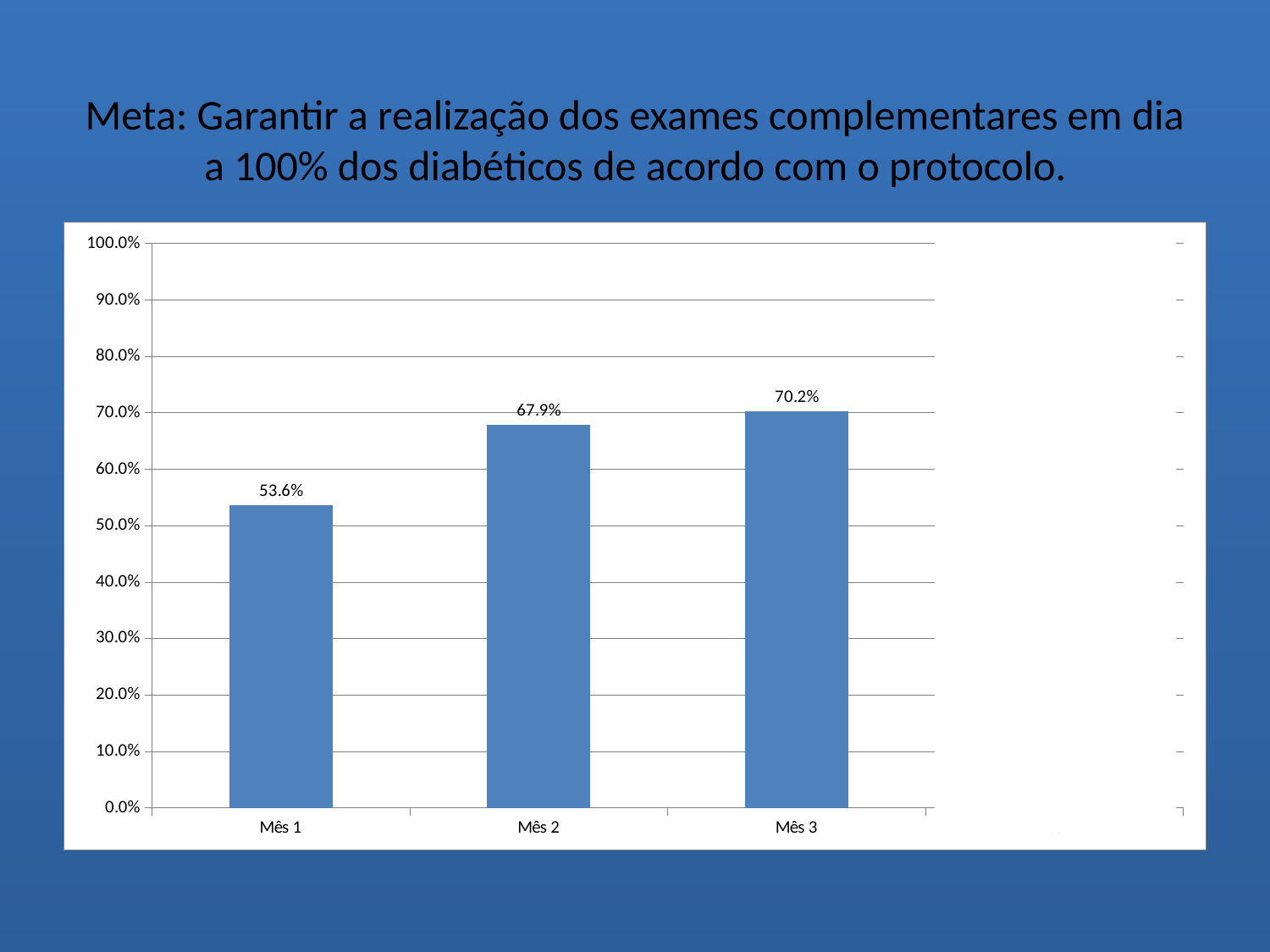
What kind of chart is shown on the slide? bar chart What is the difference between the values for Mês 3 and Mês 2? 2.3% What is the value for Mês 2? 67.9% What is the difference between the values for Mês 2 and Mês 1? 14.3% Which month has the lowest value? Mês 1 Do the values rise or fall from Mês 1 to Mês 3? rise Which is larger, the value for Mês 1 or the value for Mês 2? Mês 2 How many months are shown on the x axis? 3 What is the value for Mês 3? 70.2% What is the value for Mês 1? 53.6% Is the value for Mês 1 greater or less than 60.0%? less Which month has the highest value? Mês 3